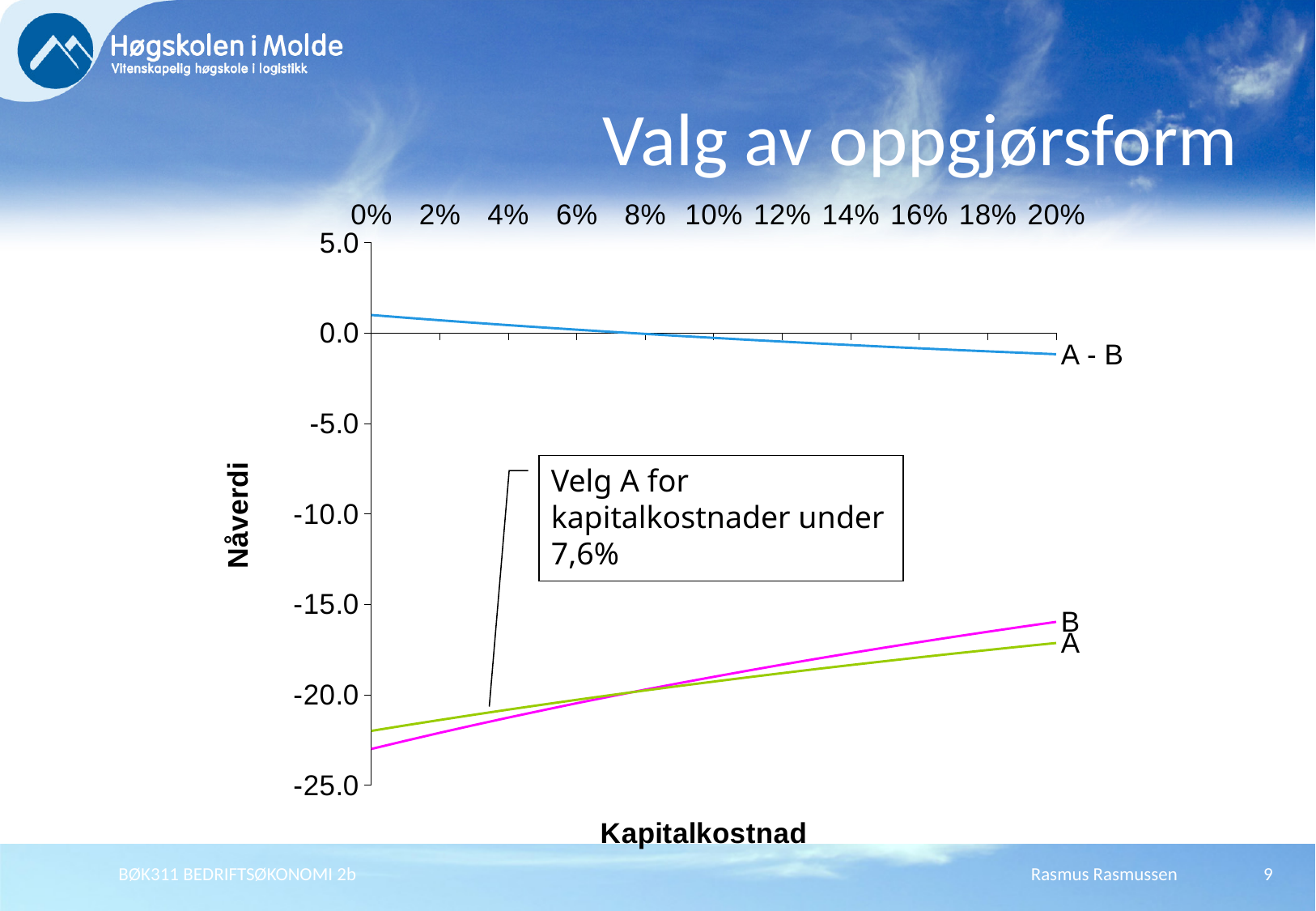
At 0% Kapitalkostnad, which series has the higher value, A or B? A What kind of chart is shown on the slide? line chart At 20% Kapitalkostnad, which series has the higher value, A or B? B Does the line for A rise or fall as Kapitalkostnad increases from 0% to 20%? rise Is the value for A at 0% greater or less than -20.0? less Is the value for B at 20% greater or less than -20.0? greater How many series are plotted in the chart? 3 Is the value for A - B at 0% greater or less than 0.0? greater Does the line for A - B rise or fall as Kapitalkostnad increases from 0% to 20%? fall What is the title of the vertical axis? Nåverdi What is the title of the horizontal axis? Kapitalkostnad